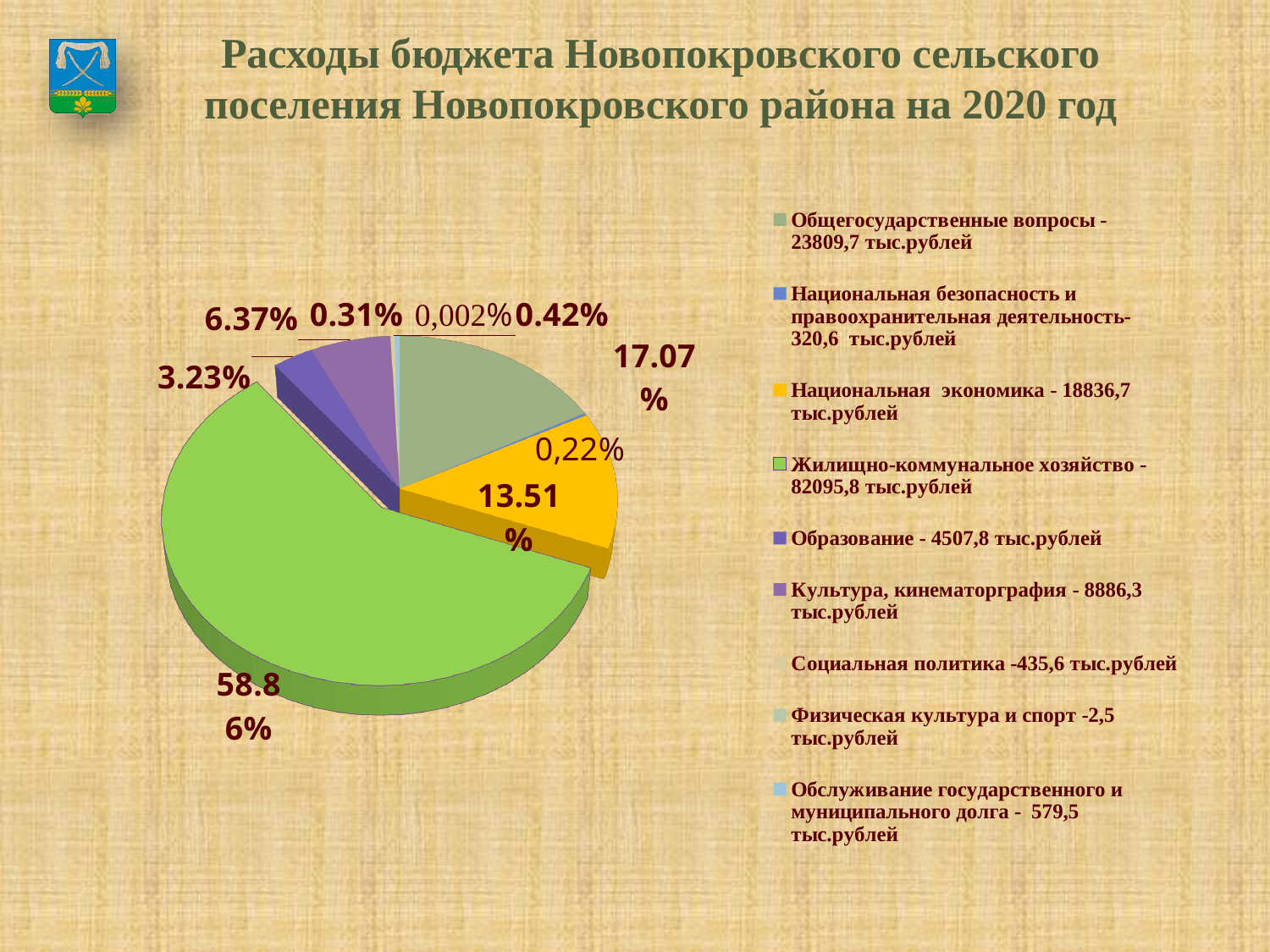
What share of the pie does Жилищно-коммунальное хозяйство take? 58.86% What is the difference between Культура, кинематорграфия and Образование? 4378,5 тыс.рублей What is the value for Национальная экономика? 18836,7 тыс.рублей What is the value for Образование? 4507,8 тыс.рублей Which category has the lowest value? Физическая культура и спорт What kind of chart is shown on the slide? Pie chart How many categories does the pie chart show? 9 What is the value for Жилищно-коммунальное хозяйство? 82095,8 тыс.рублей Which is larger: Общегосударственные вопросы or Национальная экономика? Общегосударственные вопросы What is the value for Физическая культура и спорт? 2,5 тыс.рублей Which category has the highest value? Жилищно-коммунальное хозяйство What share of the pie does Общегосударственные вопросы take? 17.07%